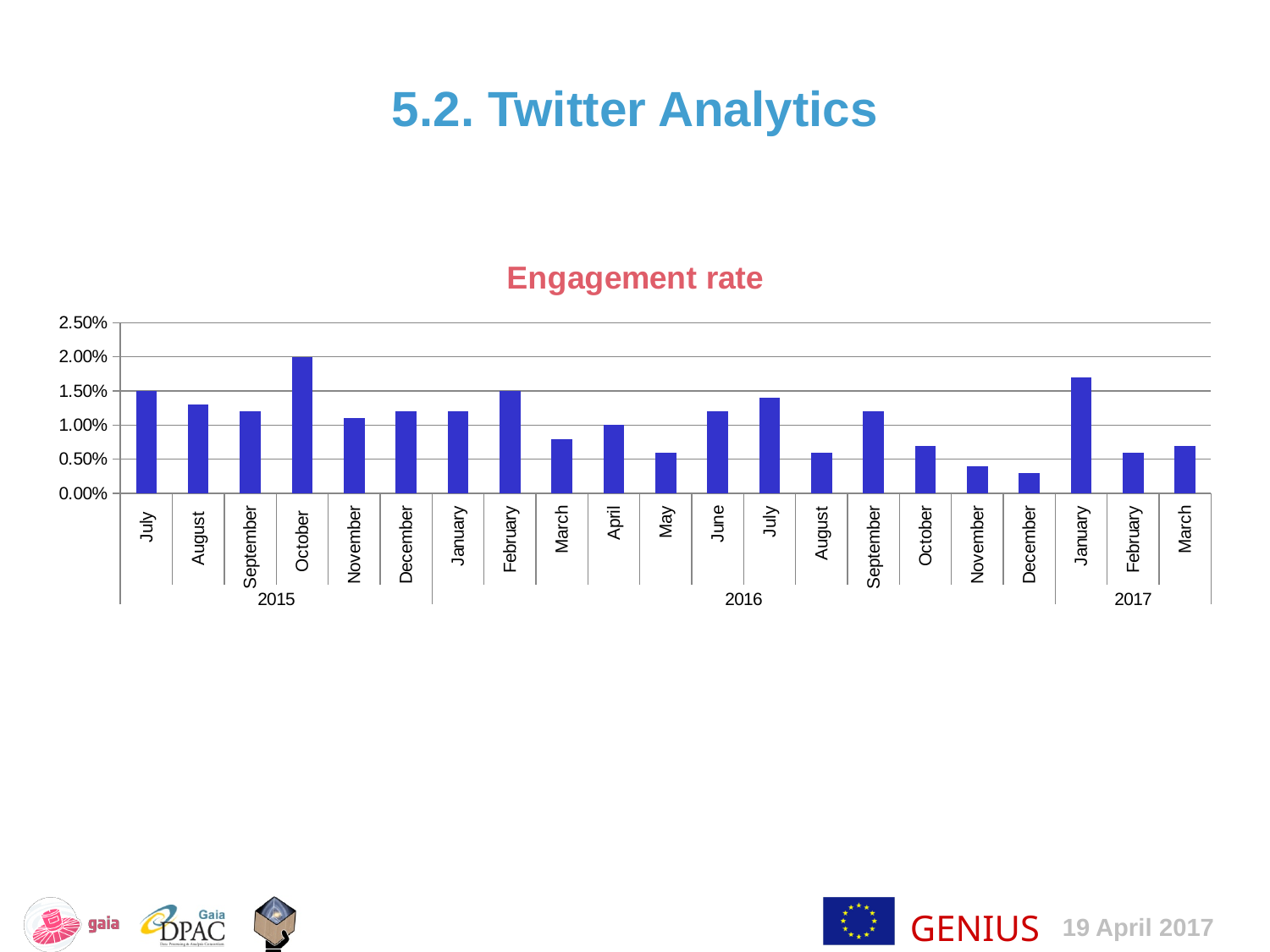
Which month has the lowest engagement rate? December 2016 What is the engagement rate for October 2015? 2.00% Which has a higher engagement rate, March 2016 or July 2016? July 2016 How many monthly bars are plotted in the chart? 21 What is the engagement rate for April 2016? 1.00% Is the engagement rate for December 2016 greater or less than 0.50%? less What is the title of the chart? Engagement rate What is the engagement rate for July 2015? 1.50% Which month has the highest engagement rate? October 2015 What type of chart is shown on the slide? bar chart Do the engagement rates rise or fall from September 2016 to December 2016? fall Is the engagement rate for January 2017 greater or less than 1.50%? greater